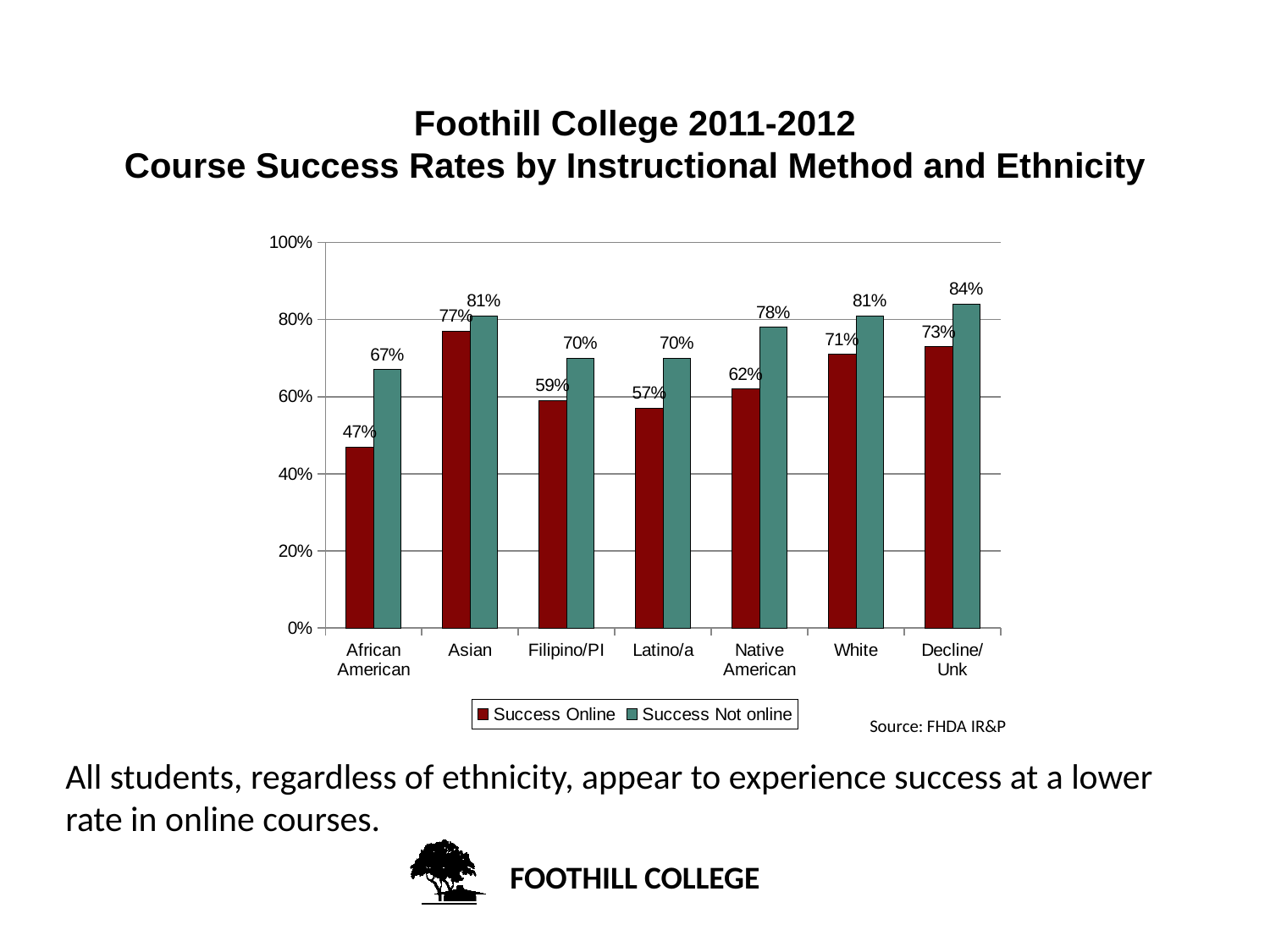
Which is larger for White students: the Success Online rate or the Success Not online rate? Success Not online What is the source cited for the chart data? FHDA IR&P Which ethnicity category has the lowest Success Not online rate? African American What kind of chart is shown on the slide? Bar chart Is the Success Online rate for Latino/a students greater or less than 60%? less Which ethnicity category has the highest Success Online rate? Asian What is the Success Not online rate for Native American students? 78% What is the Success Not online rate for the Decline/Unk category? 84% What is the difference between the Success Not online and Success Online rates for African American students? 20% How many ethnicity categories are shown on the x axis? 7 How many series does the legend list? 2 What is the Success Online rate for African American students? 47%